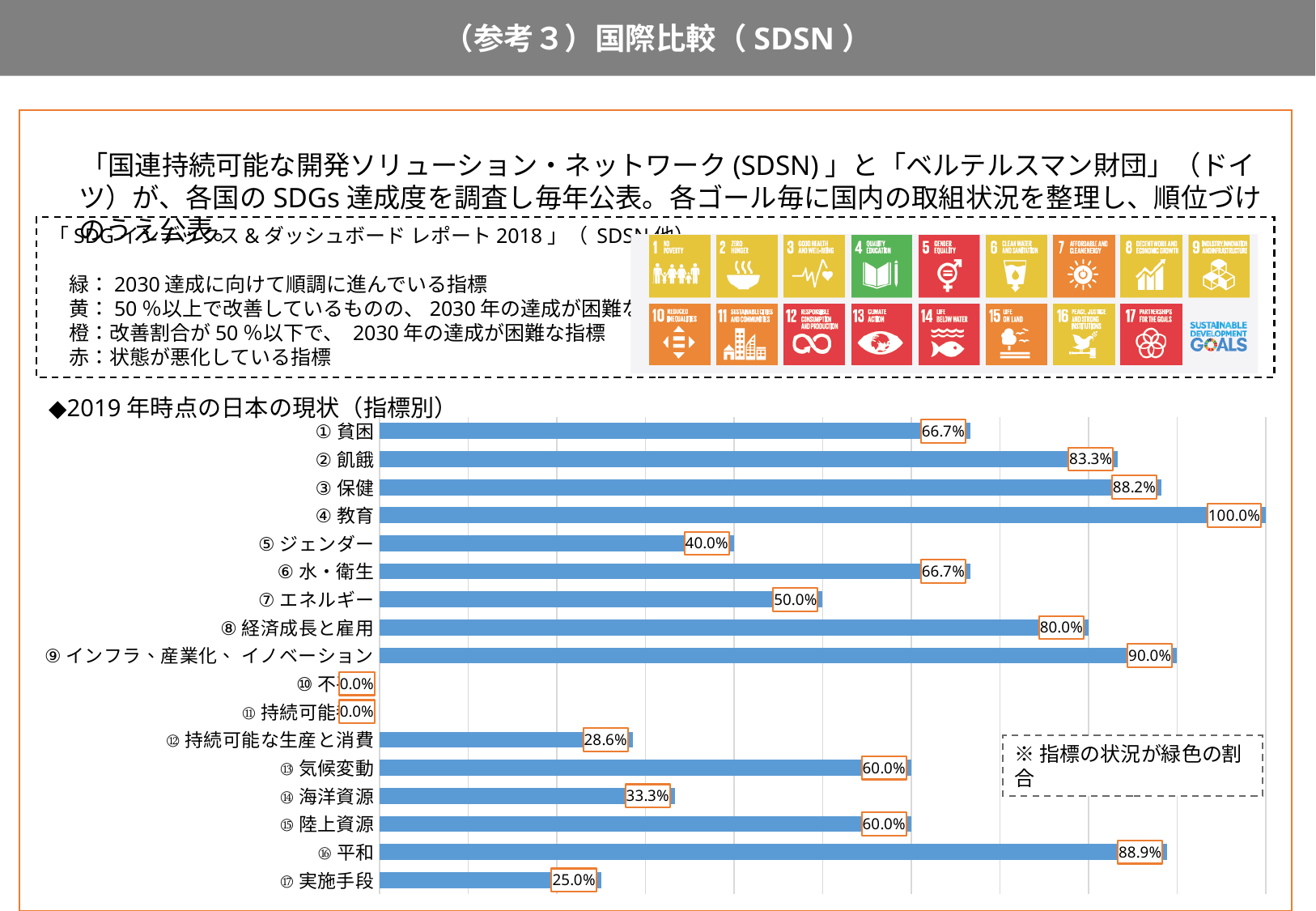
What is the value for ⑫ 持続可能な生産と消費? 28.6% What type of chart is shown on the slide? bar chart What is the value for ⑯ 平和? 88.9% What is the title shown above the chart? ◆2019年時点の日本の現状（指標別） Which category has the highest value? ④ 教育 What is the difference between the values for ⑨ インフラ、産業化、イノベーション and ⑧ 経済成長と雇用? 10.0% How many categories are plotted in the chart? 17 What is the value for ④ 教育? 100.0% What is the value for ⑤ ジェンダー? 40.0% What is the difference between the values for ③ 保健 and ② 飢餓? 4.9% Which is larger, the value for ⑦ エネルギー or the value for ⑬ 気候変動? ⑬ 気候変動 Which is larger, the value for ⑭ 海洋資源 or the value for ⑰ 実施手段? ⑭ 海洋資源